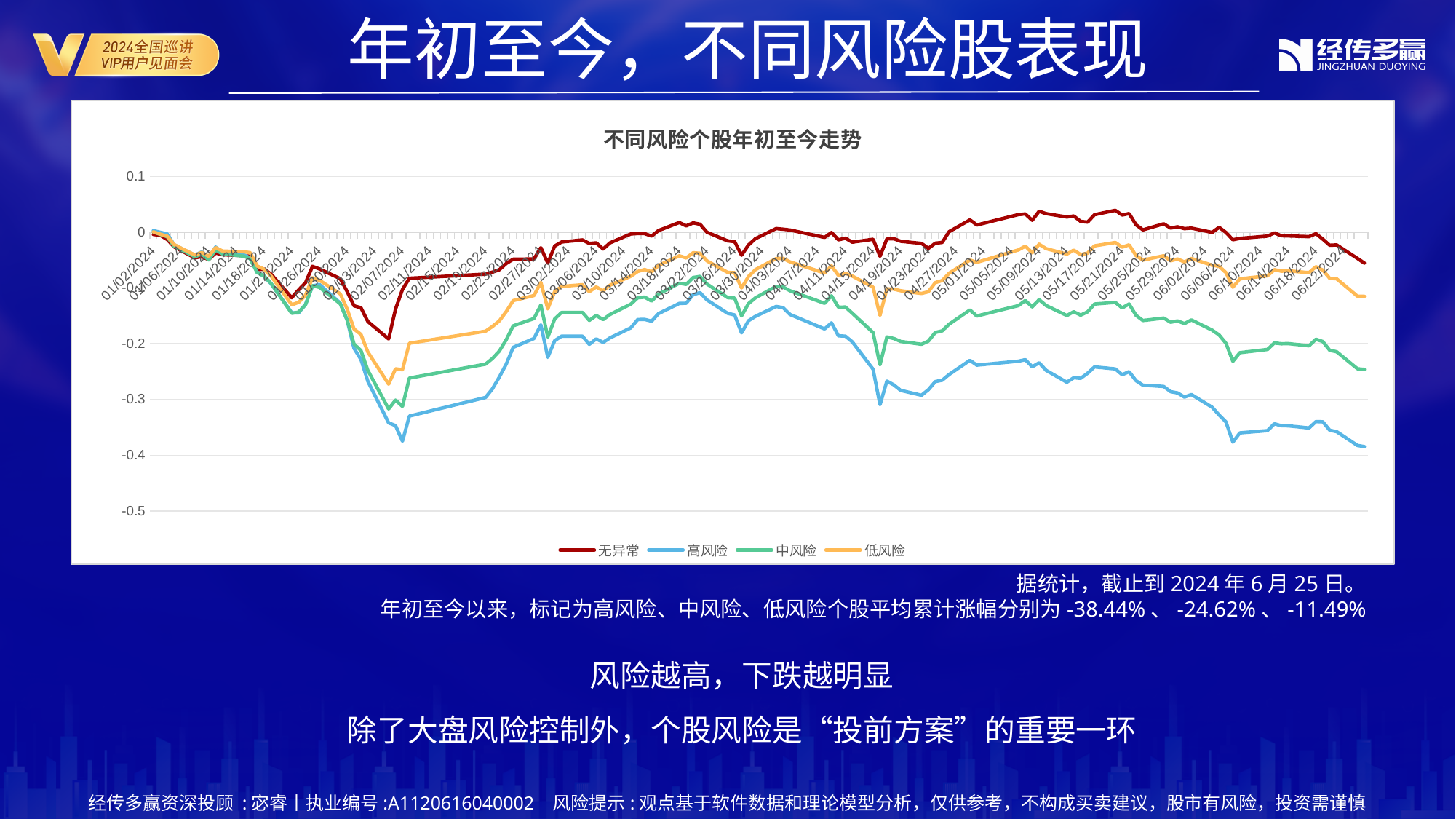
Is the value of the 低风险 line at the right end of the chart greater or less than -0.2? greater Is the lowest point of the 高风险 line, around 02/07/2024, greater or less than -0.3? less What kind of chart is shown on the slide? line chart What is the title of the chart? 不同风险个股年初至今走势 How many series does the chart legend list? 4 Is the value of the 高风险 line at the right end of the chart greater or less than -0.3? less Which colour is used for the 高风险 line in the chart? blue Which series is the lowest at the right end of the chart? 高风险 Which series is the highest at the right end of the chart? 无异常 At the right end of the chart, which is higher: 中风险 or 低风险? 低风险 Does the 高风险 line rise or fall from the start of the chart to its end? fall